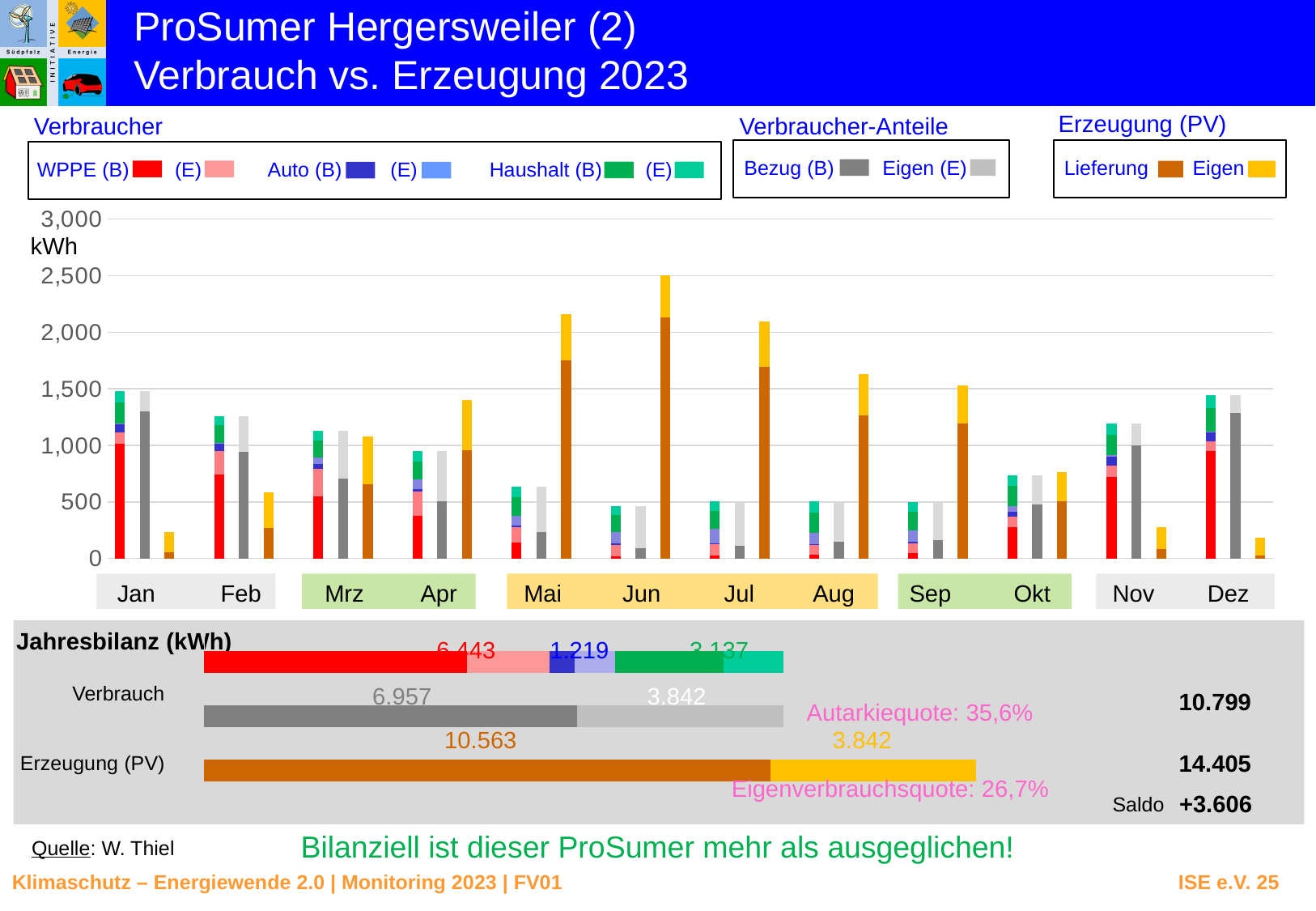
In the Jahresbilanz chart, which is larger: the WPPE value (6.443) or the Haushalt value (3.137)? WPPE In the Jahresbilanz chart, what is the Lieferung value of the Erzeugung (PV) bar? 10.563 In the Jahresbilanz chart, what is the annual Verbrauch total in kWh? 10.799 How many entries does the Erzeugung (PV) legend list? 2 In the Jahresbilanz chart, what is the Saldo value? +3.606 In the monthly chart, is the Erzeugung (PV) bar for Jun greater or less than 2,000 kWh? greater In the monthly chart, which month has the highest Erzeugung (PV) bar? Jun In the Jahresbilanz chart, what is the annual Erzeugung (PV) total in kWh? 14.405 In the Jahresbilanz chart, what is the difference between the Lieferung value (10.563) and the Eigen value (3.842) of the Erzeugung (PV) bar? 6.721 In the Jahresbilanz chart, what is the WPPE share of the annual Verbrauch in kWh? 6.443 How many months are shown on the x axis of the monthly chart? 12 In the monthly chart, is the Erzeugung (PV) bar for Jan greater or less than 500 kWh? less